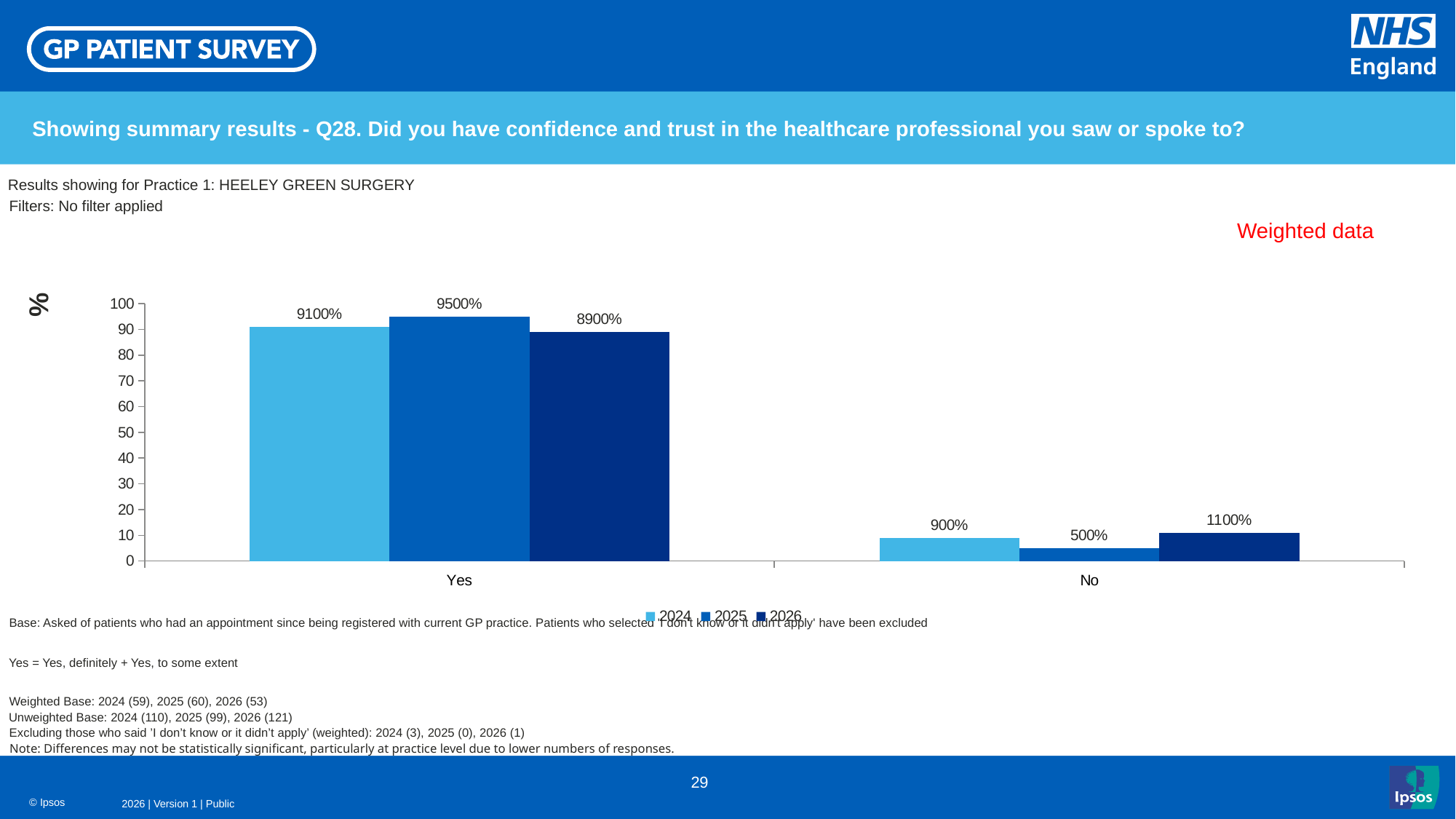
What is the data label shown for 2025 in the No category? 500% How many categories are shown on the x axis? 2 Which year has the lowest bar in the No category? 2025 What is the data label shown for 2024 in the No category? 900% Which is larger in the No category, the 2024 bar or the 2026 bar? 2026 Is the 2026 bar in the Yes category greater or less than 80 on the axis? greater What is the data label shown for 2026 in the Yes category? 8900% How many series does the legend list? 3 What kind of chart is shown on the slide? Bar chart What is the label on the vertical axis? % Which year has the highest bar in the Yes category? 2025 What is the data label shown for 2025 in the Yes category? 9500%